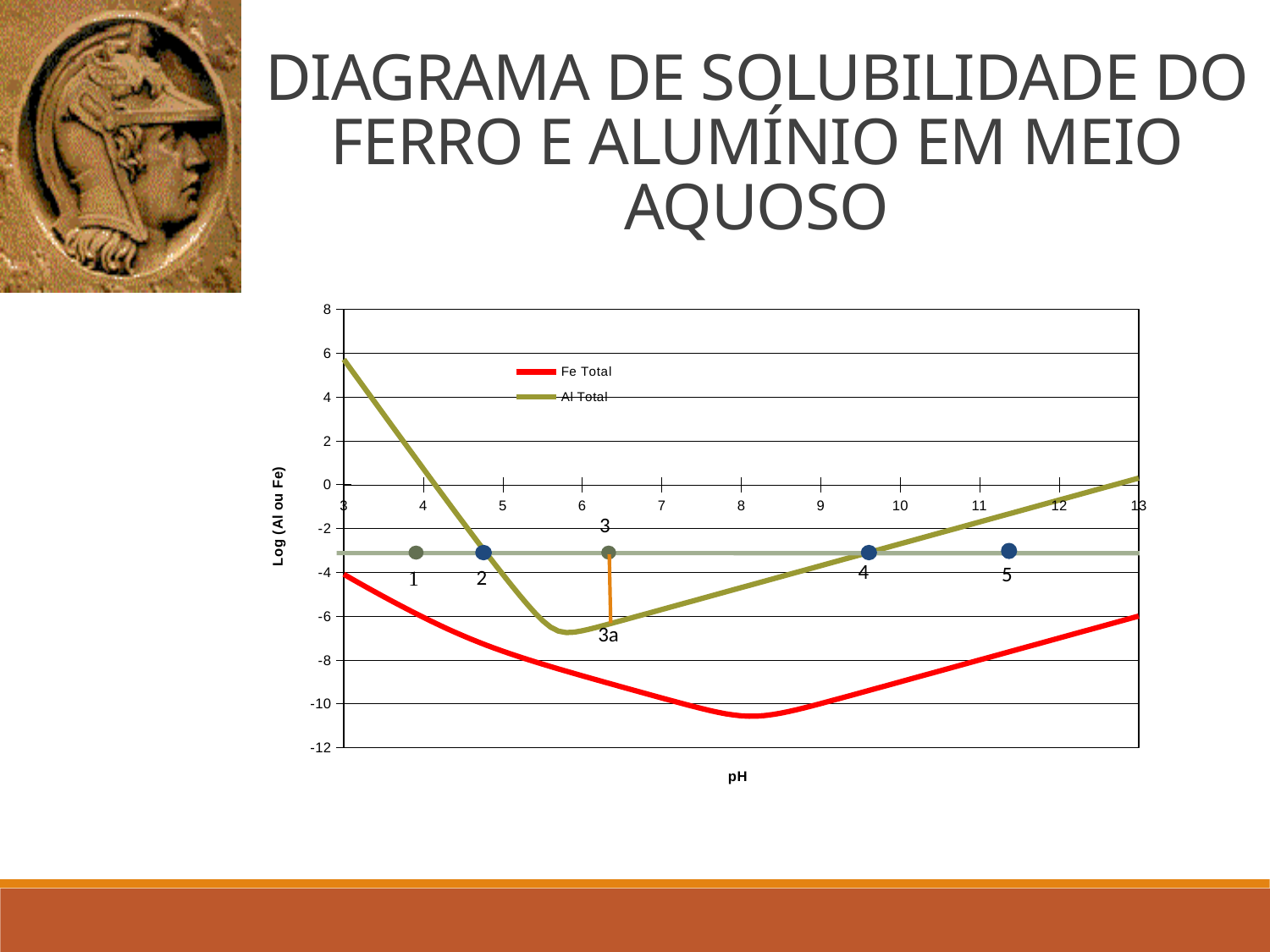
Is the Al Total value at pH 6 greater or less than -4? less Is the Fe Total value at pH 8 greater or less than -8? less Is the Al Total value at pH 3 greater or less than 4? greater How many series does the chart legend list? 2 What kind of chart is shown on the slide? line chart Which series is drawn in red? Fe Total At pH 8, which series has the higher value, Fe Total or Al Total? Al Total What are the two series named in the chart legend? Fe Total and Al Total Does the Al Total curve rise or fall as pH increases from 8 to 13? rise What is the label of the x axis? pH Does the Fe Total curve rise or fall as pH increases from 3 to 8? fall